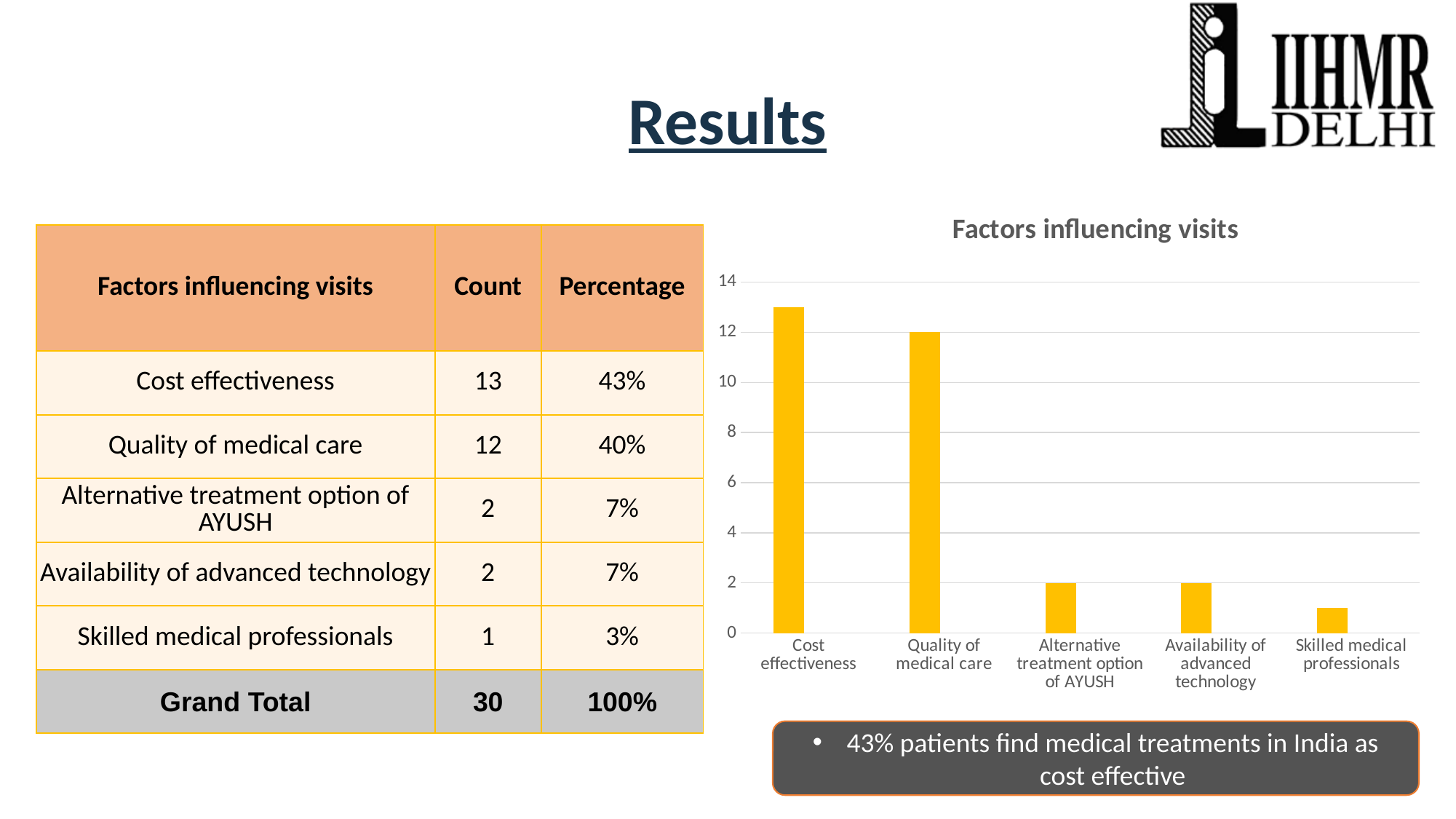
Which is larger in the chart, Quality of medical care or Alternative treatment option of AYUSH? Quality of medical care What is the value for Quality of medical care in the chart? 12 How many categories are shown on the x axis of the chart? 5 What is the value for Cost effectiveness in the chart? 13 Which category has the lowest bar in the chart? Skilled medical professionals What is the value for Availability of advanced technology in the chart? 2 Which category has the highest bar in the chart? Cost effectiveness Is the value for Cost effectiveness greater or less than 12? greater What is the difference between the values for Cost effectiveness and Quality of medical care? 1 What is the title of the chart? Factors influencing visits What type of chart is shown on the slide? bar chart Is the value for Skilled medical professionals greater or less than 2? less